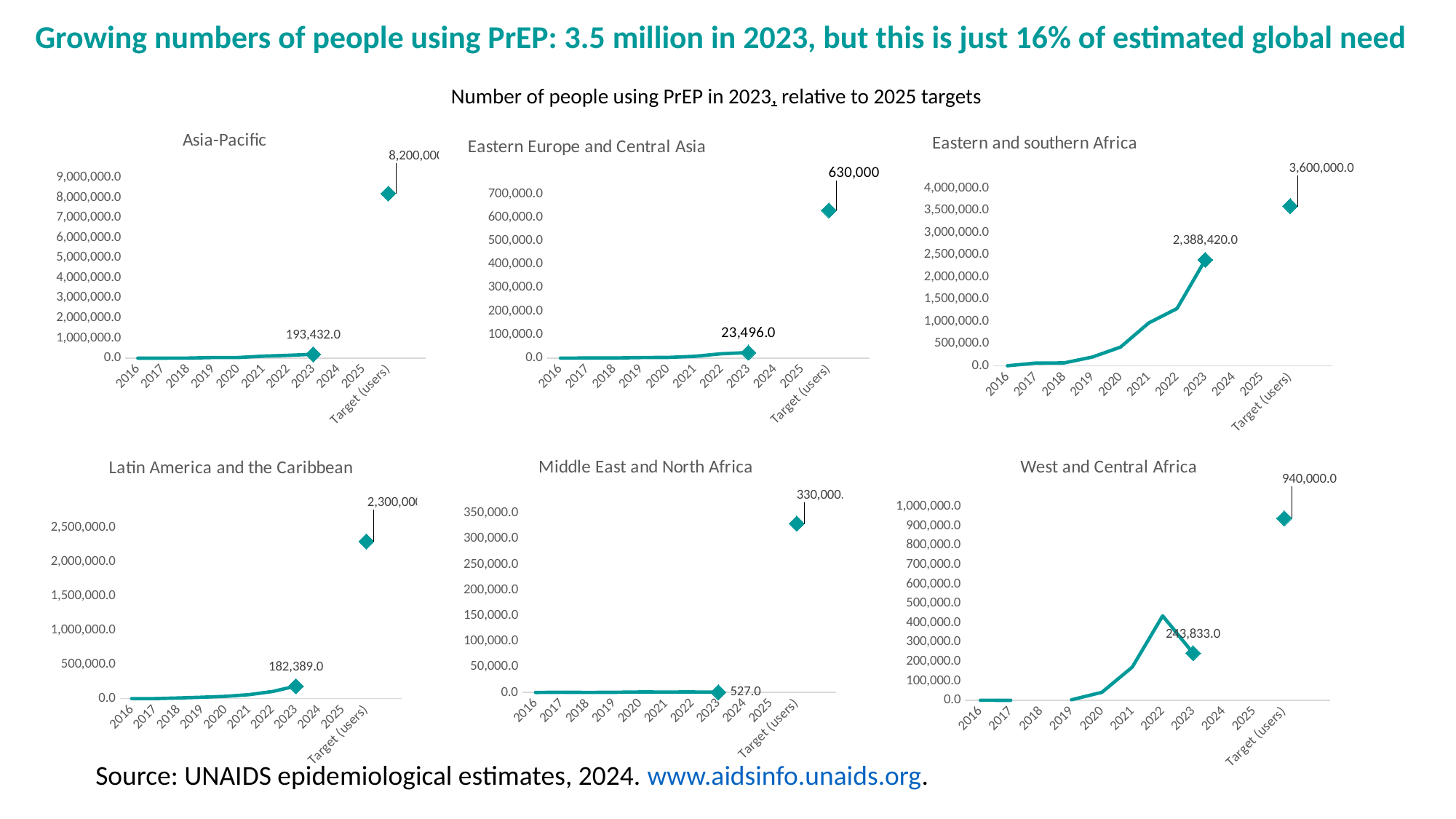
In the Eastern Europe and Central Asia chart, what is the value for 2023? 23,496.0 In the Eastern and southern Africa chart, what is the number of people using PrEP in 2023? 2,388,420.0 In the Eastern and southern Africa chart, do the values rise or fall from 2016 to 2023? rise In the West and Central Africa chart, how much higher is the target (users) than the 2023 value? 696,167.0 In the Middle East and North Africa chart, what is the value for 2023? 527.0 What kind of chart is used for each region on this slide? line chart In the West and Central Africa chart, what is the value for 2023? 243,833.0 In the Eastern and southern Africa chart, what is the 2025 target (users)? 3,600,000.0 In the Eastern and southern Africa chart, what is the difference between the target (users) and the 2023 value? 1,211,580.0 In the Latin America and the Caribbean chart, what is the value for 2023? 182,389.0 In the West and Central Africa chart, what is the target (users) value? 940,000.0 In the Asia-Pacific chart, is the target (users) value greater or less than 8,000,000.0? greater